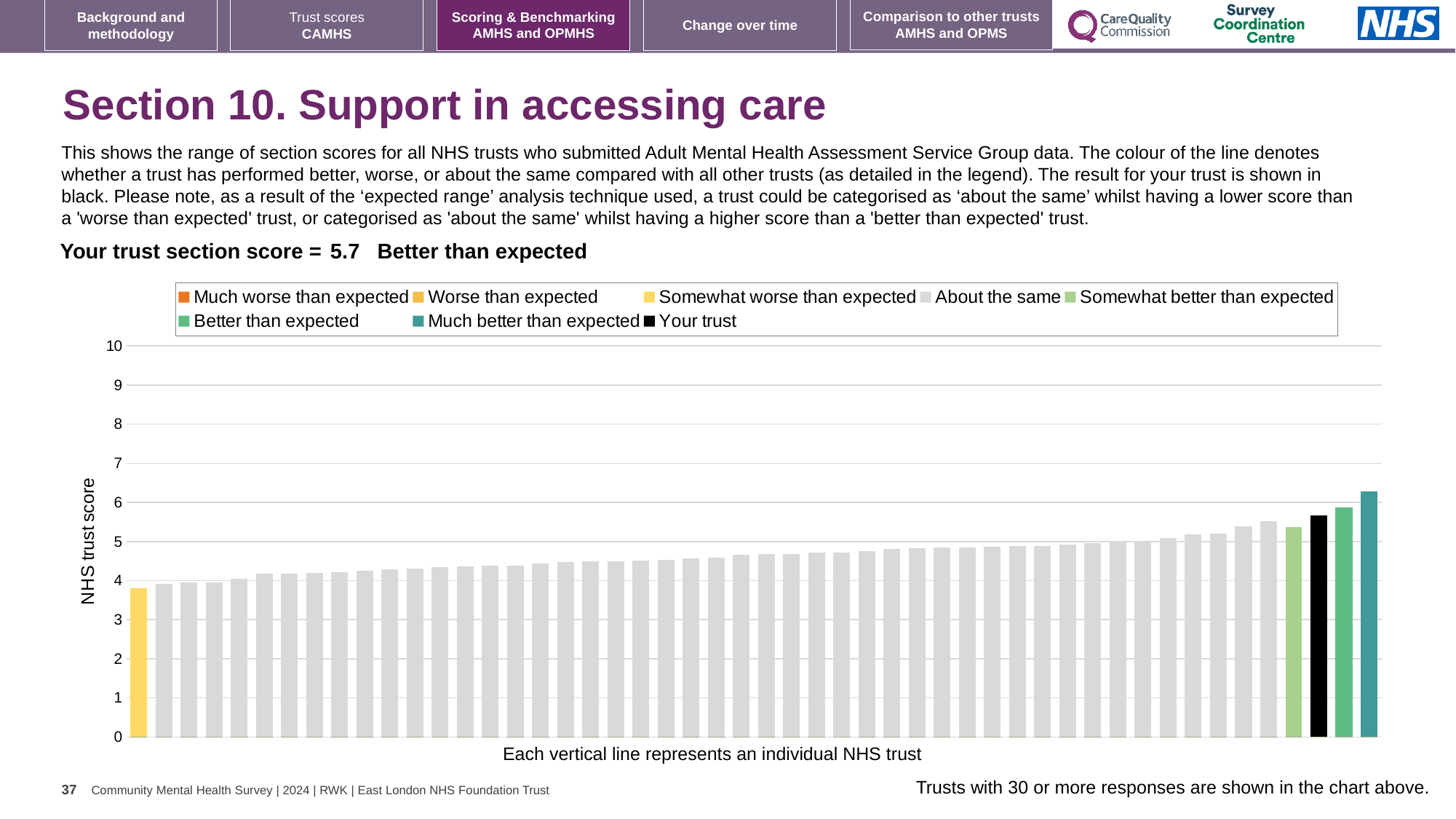
How many entries does the chart legend list? 8 Do the bar values rise or fall from left to right along the x axis? rise How many bars are shown in a colour other than grey? 5 Is the value of the tallest bar greater or less than 6? greater What is the section score for your trust? 5.7 Is the value of the shortest bar greater or less than 5? less Is the value for your trust greater or less than 6? less What kind of chart is shown on the slide? bar chart What is the label on the y axis of the chart? NHS trust score What colour is used for the bar representing your trust? black Which legend category does the tallest bar in the chart belong to? Much better than expected Which is larger: the bar for your trust or the bar immediately to its right? the bar immediately to its right